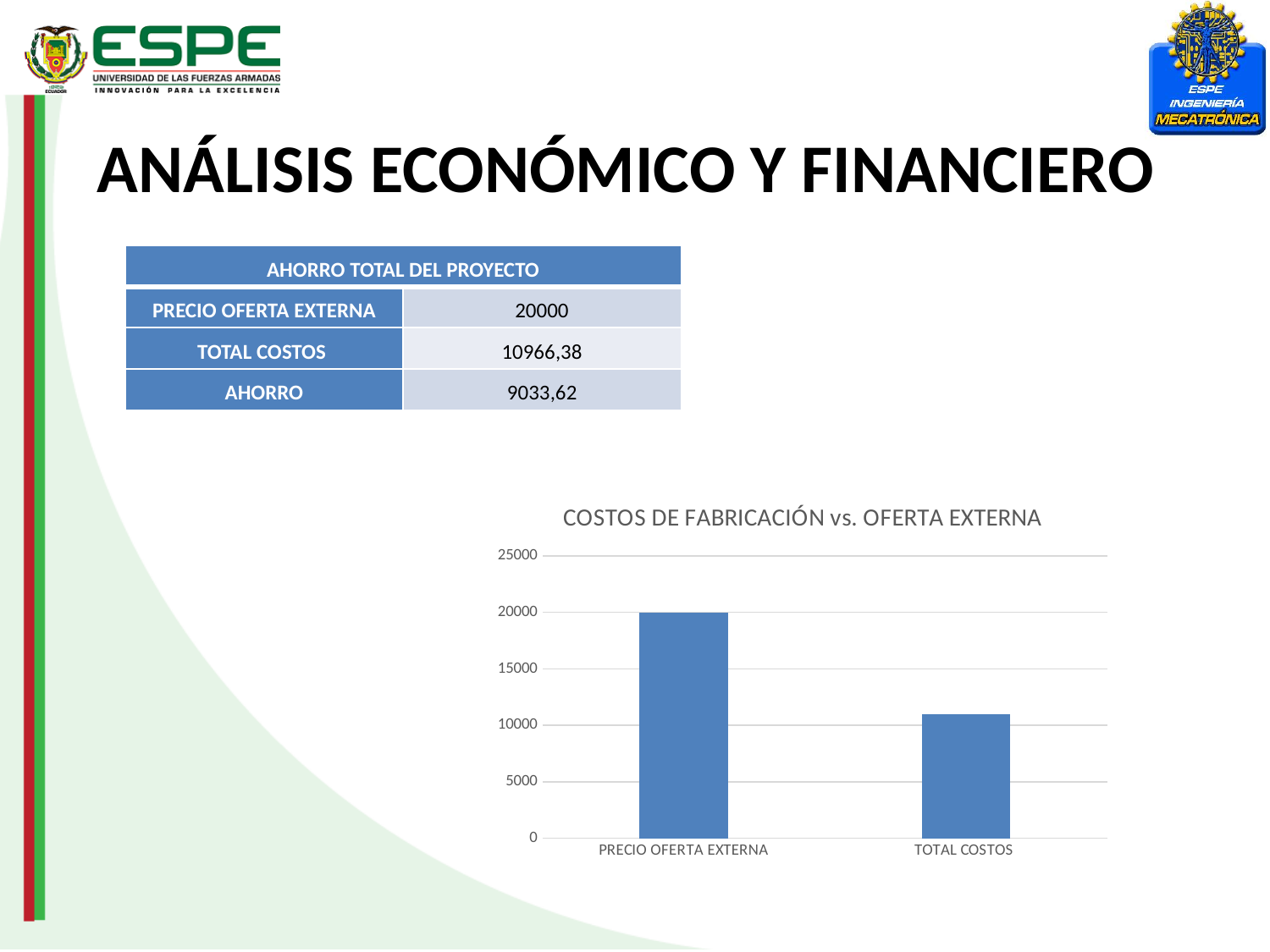
How many categories are plotted in the chart? 2 Which category has the lowest bar in the chart? TOTAL COSTOS What kind of chart is shown on the slide? bar chart Which is larger, the bar for PRECIO OFERTA EXTERNA or the bar for TOTAL COSTOS? PRECIO OFERTA EXTERNA Is the value for TOTAL COSTOS greater or less than 10000? greater What colour are the bars in the chart? blue Is the value for PRECIO OFERTA EXTERNA greater or less than 25000? less Which category has the highest bar in the chart? PRECIO OFERTA EXTERNA Is the value for TOTAL COSTOS greater or less than 15000? less What is the title of the chart? COSTOS DE FABRICACIÓN vs. OFERTA EXTERNA What is the value of the bar for PRECIO OFERTA EXTERNA? 20000 Do the bar values rise or fall from left to right along the x axis? fall